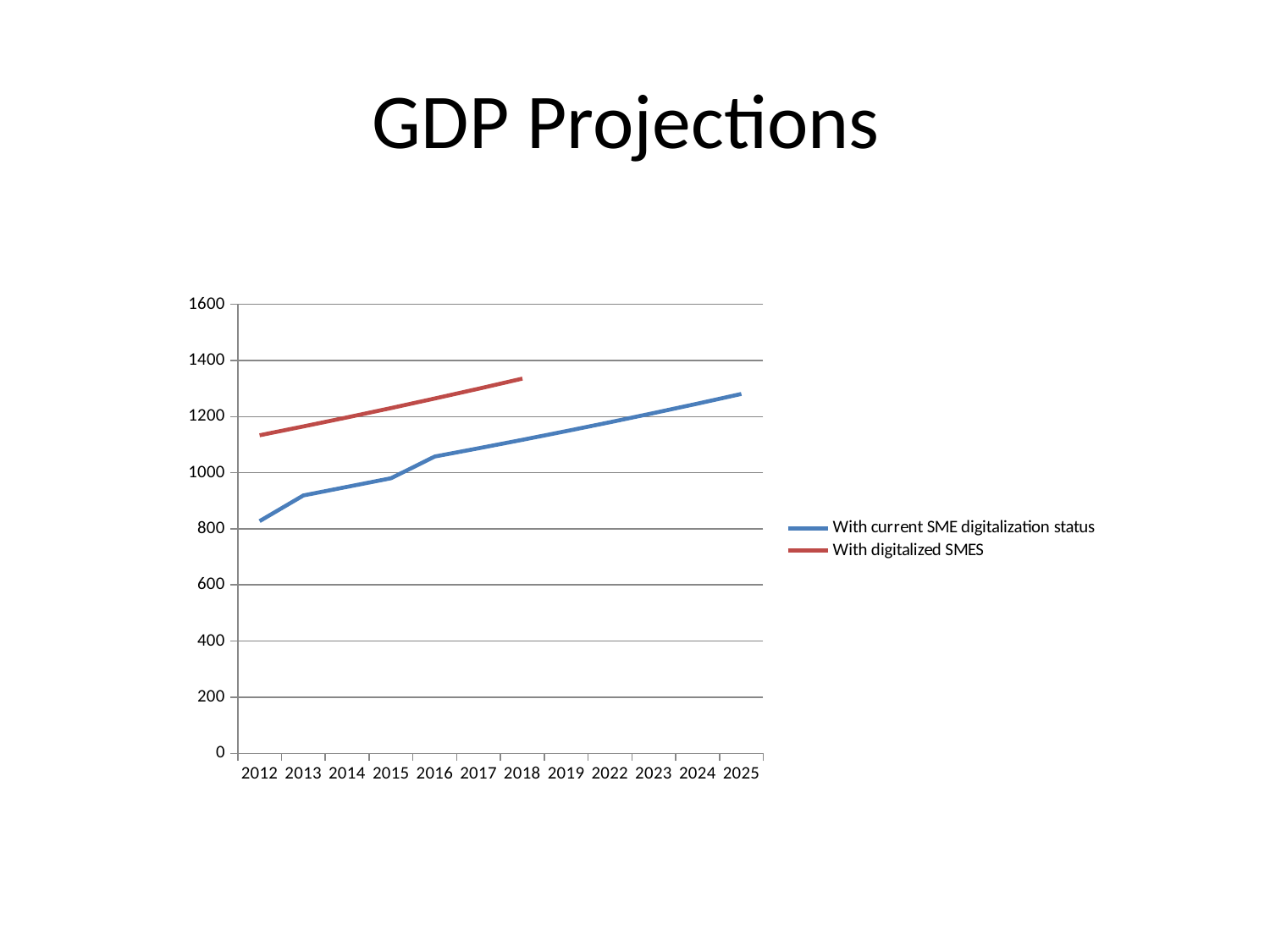
Is the value for 'With current SME digitalization status' in 2012 greater or less than 1000? less Is the value for 'With digitalized SMES' in 2012 greater or less than 1000? greater How many years are shown on the x axis? 12 In 2012, which series has the larger value: 'With current SME digitalization status' or 'With digitalized SMES'? With digitalized SMES What is the title of the chart? GDP Projections How many series does the legend list? 2 Is the value for 'With current SME digitalization status' in 2025 greater or less than 1400? less Does the 'With current SME digitalization status' line rise or fall from 2012 to 2025? rise What kind of chart is shown on the slide? line chart Which series is drawn in red? With digitalized SMES